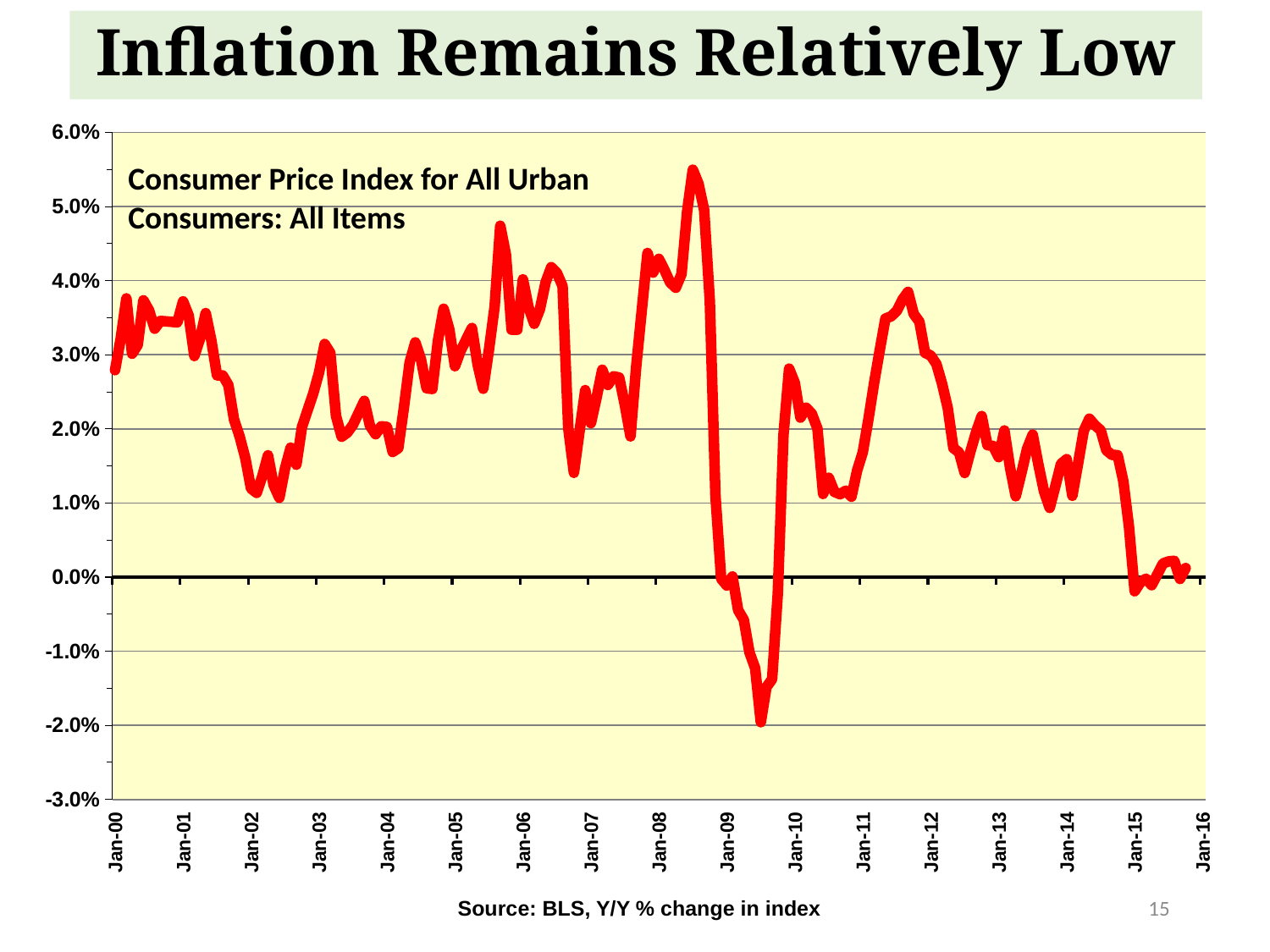
In which year does the line reach its highest value? 2008 What series does the chart plot, according to the label inside the plot area? Consumer Price Index for All Urban Consumers: All Items How many year labels (Jan-00 through Jan-16) are shown on the x axis? 17 In which year does the line reach its lowest value? 2009 What is the source cited below the chart? BLS, Y/Y % change in index Is the value at Jan-13 greater or less than 2.0%? less Is the value at Jan-12 greater or less than 2.0%? greater Between Jan-11 and Jan-12, does the line generally rise or fall? rise Is the value at Jan-15 greater or less than 1.0%? less Between Jan-14 and Jan-15, does the line generally rise or fall? fall What kind of chart is shown on the slide? line chart